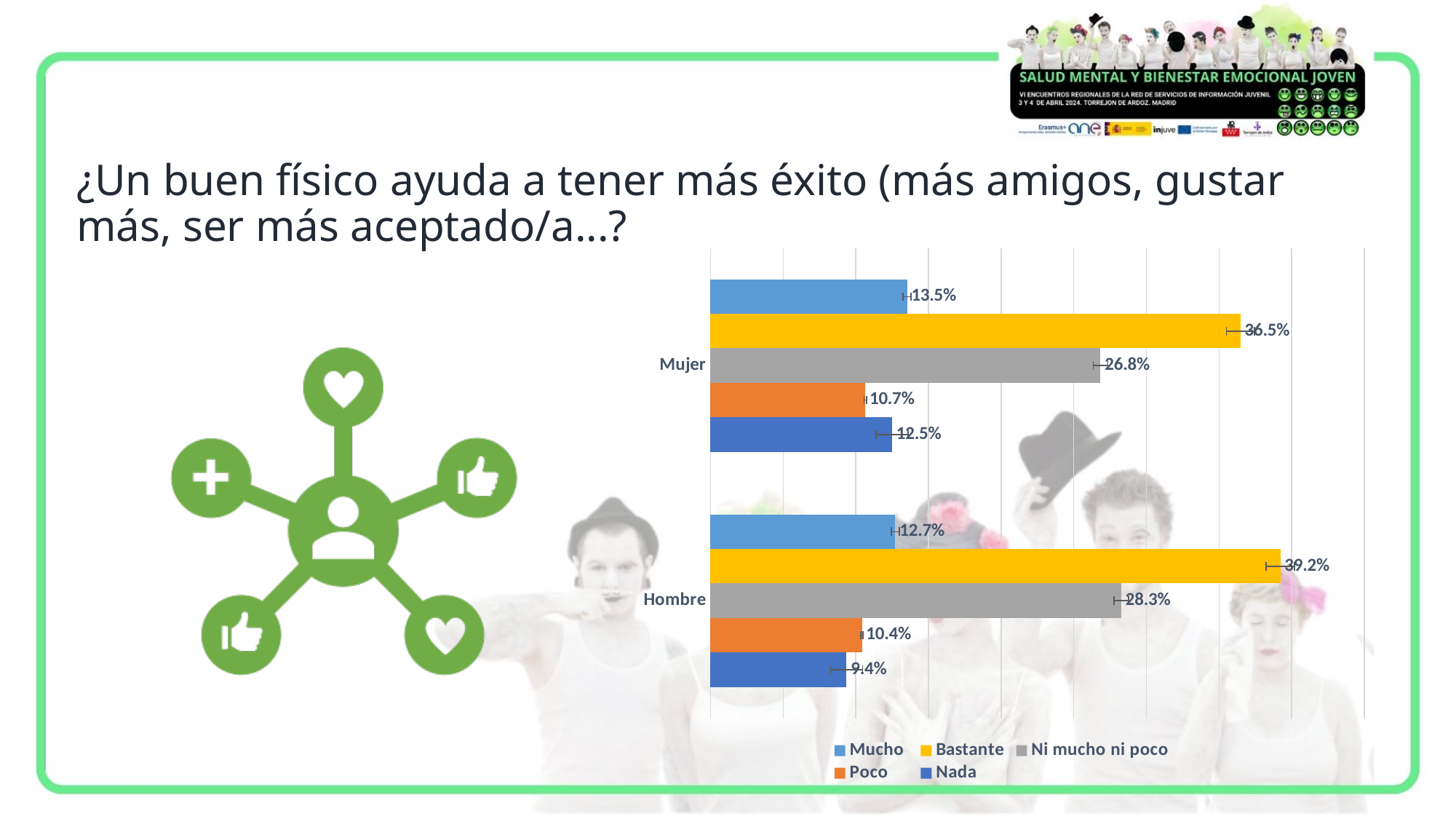
What is the value for Ni mucho ni poco in the Hombre category? 28.3% Which is larger, the Mucho value for Mujer or the Mucho value for Hombre? Mujer What is the difference between the Bastante values for Hombre and Mujer? 2.7% What is the value for Bastante in the Hombre category? 39.2% Which series has the highest value in the Hombre category? Bastante Which legend entry is shown in orange? Poco How many categories are shown on the chart? 2 Which series has the lowest value in the Hombre category? Nada How many series does the legend list? 5 What is the value for Nada in the Mujer category? 12.5% What is the value for Bastante in the Mujer category? 36.5% What kind of chart is shown on the slide? bar chart